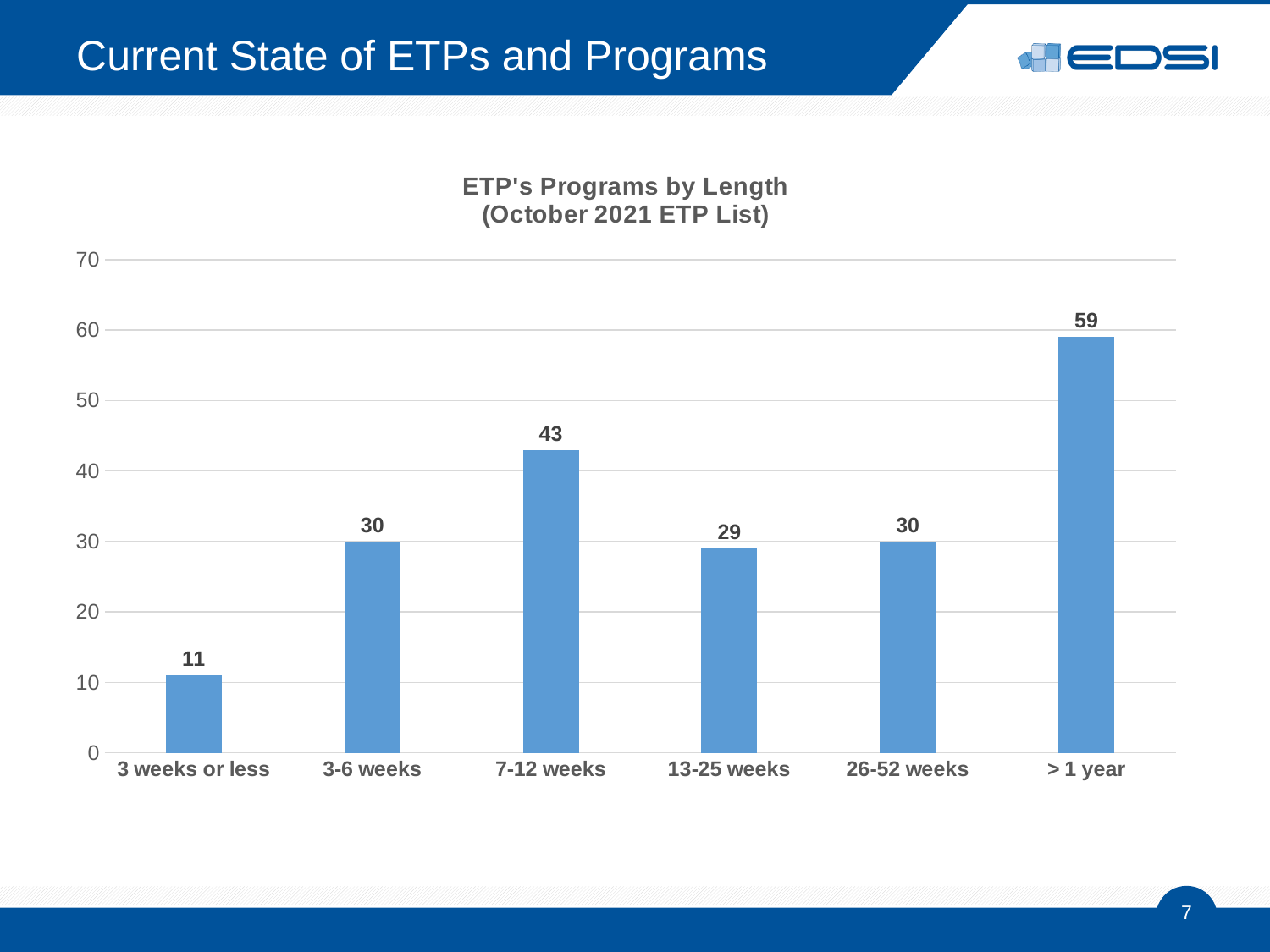
What kind of chart is shown on the slide? Bar chart What is the value for the "> 1 year" category? 59 Which category has the highest value? > 1 year What is the title of the chart? ETP's Programs by Length (October 2021 ETP List) What is the difference between the values for "3-6 weeks" and "3 weeks or less"? 19 Is the value for "> 1 year" greater or less than 50? greater What is the value for the "3 weeks or less" category? 11 Which is larger, the value for "7-12 weeks" or the value for "13-25 weeks"? 7-12 weeks How many categories are shown on the x axis? 6 Which category has the lowest value? 3 weeks or less What is the difference between the values for "> 1 year" and "7-12 weeks"? 16 What is the value for the "7-12 weeks" category? 43